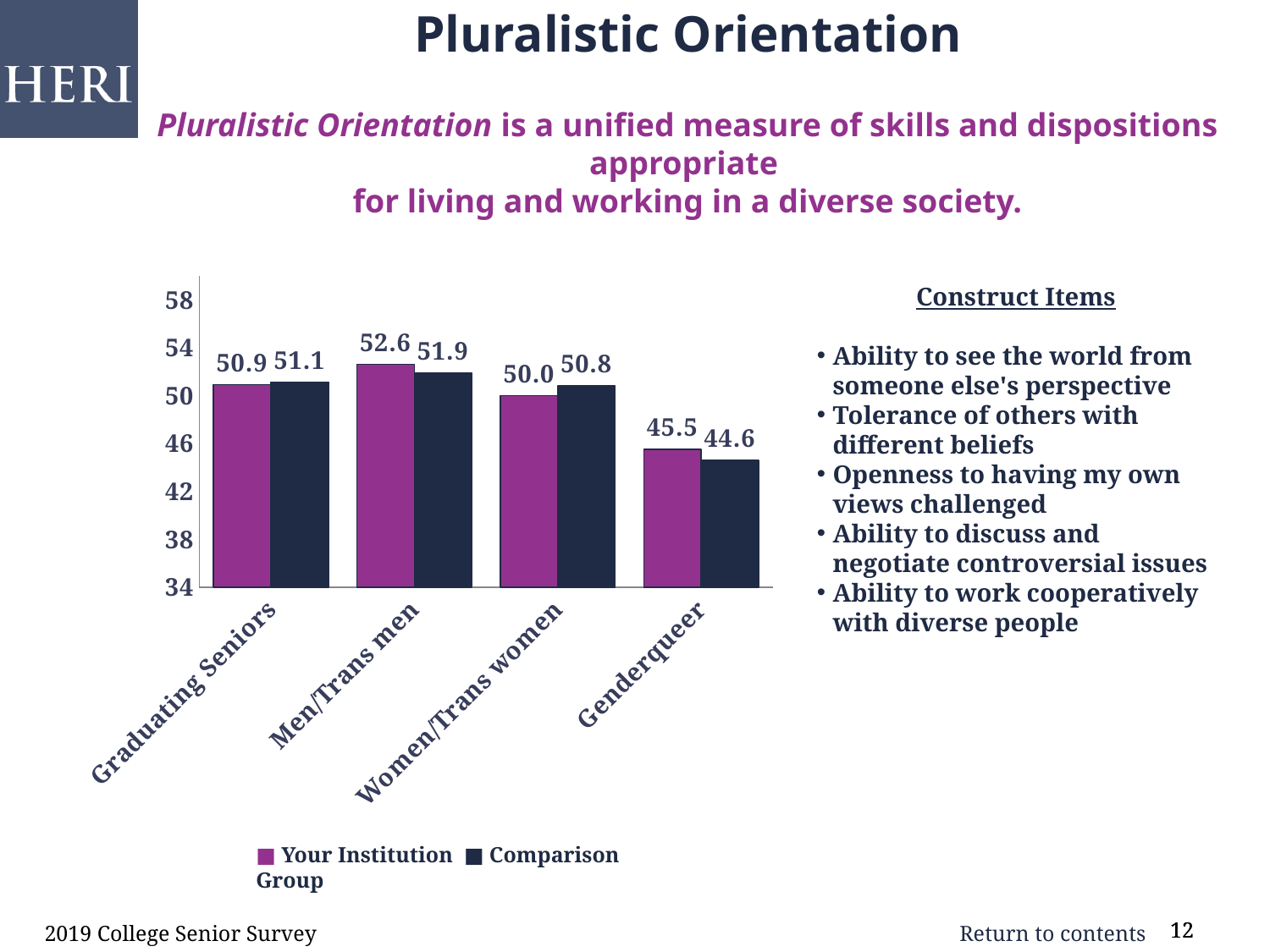
What is the difference between the Your Institution and Comparison Group values for Genderqueer? 0.9 For Women/Trans women, which is larger: the Your Institution value or the Comparison Group value? Comparison Group What kind of chart is shown on the slide? Bar chart What is the Your Institution value for Graduating Seniors? 50.9 What is the Your Institution value for Men/Trans men? 52.6 How many categories are shown on the x axis? 4 What is the Comparison Group value for Women/Trans women? 50.8 Which category has the lowest Comparison Group value? Genderqueer How many series does the legend list? 2 Which category has the highest Your Institution value? Men/Trans men What is the title of the slide containing the chart? Pluralistic Orientation What is the Comparison Group value for Genderqueer? 44.6